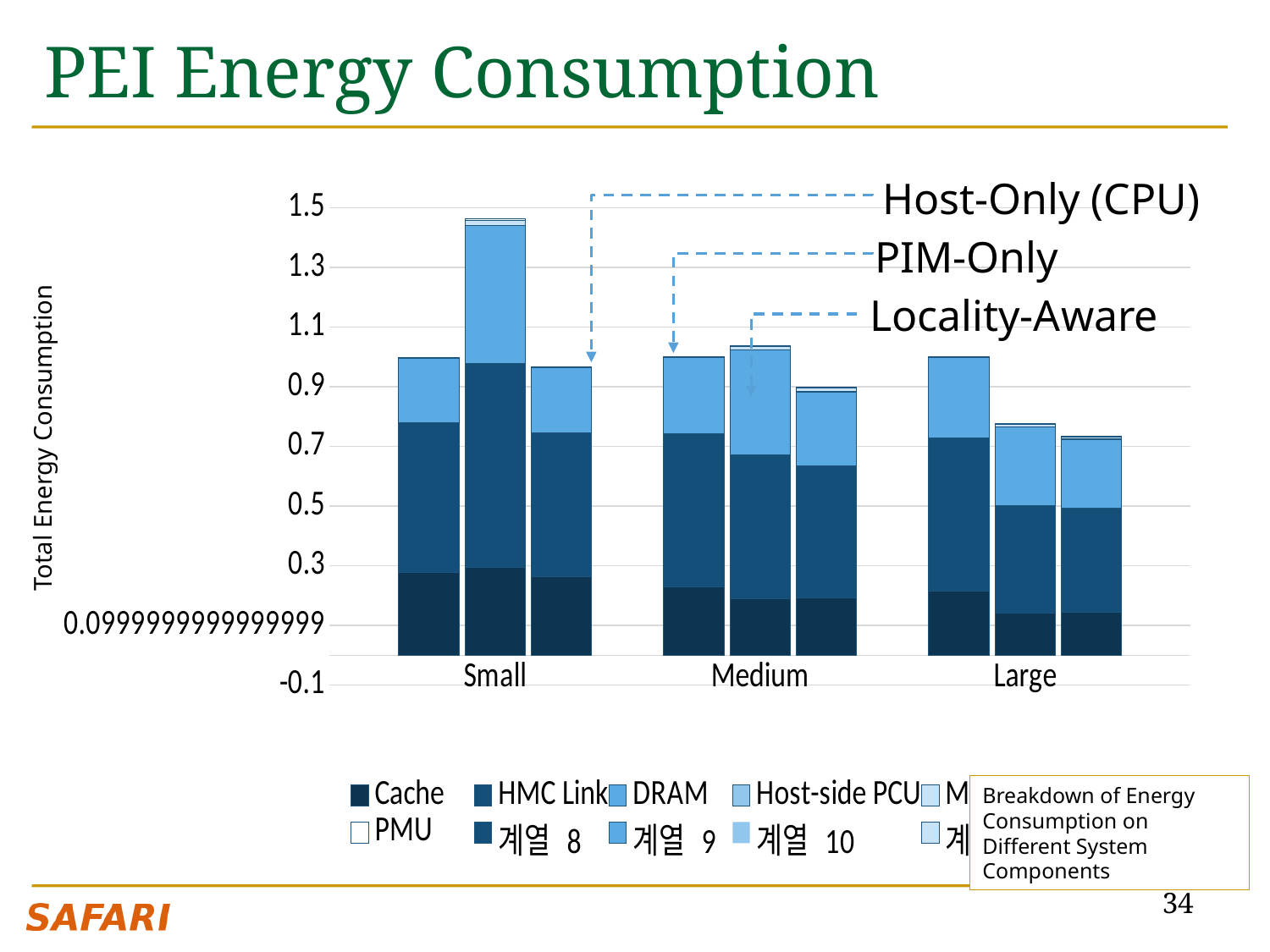
Is the Locality-Aware bar for Large greater or less than 0.9? less Which is larger for Small: the Host-Only (CPU) bar or the PIM-Only bar? PIM-Only Which is larger for Medium: the Host-Only (CPU) bar or the Locality-Aware bar? Host-Only (CPU) Is the PIM-Only bar for Large greater or less than 0.9? less How many bars are plotted in total across all groups? 9 How many workload size categories are shown on the x axis? 3 What kind of chart is shown on the slide? stacked bar chart Is the PIM-Only bar for Small greater or less than 1.3? greater What is the label on the vertical axis? Total Energy Consumption Which bar is the tallest in the chart? PIM-Only for Small Do the PIM-Only bars rise or fall from Small to Large? fall